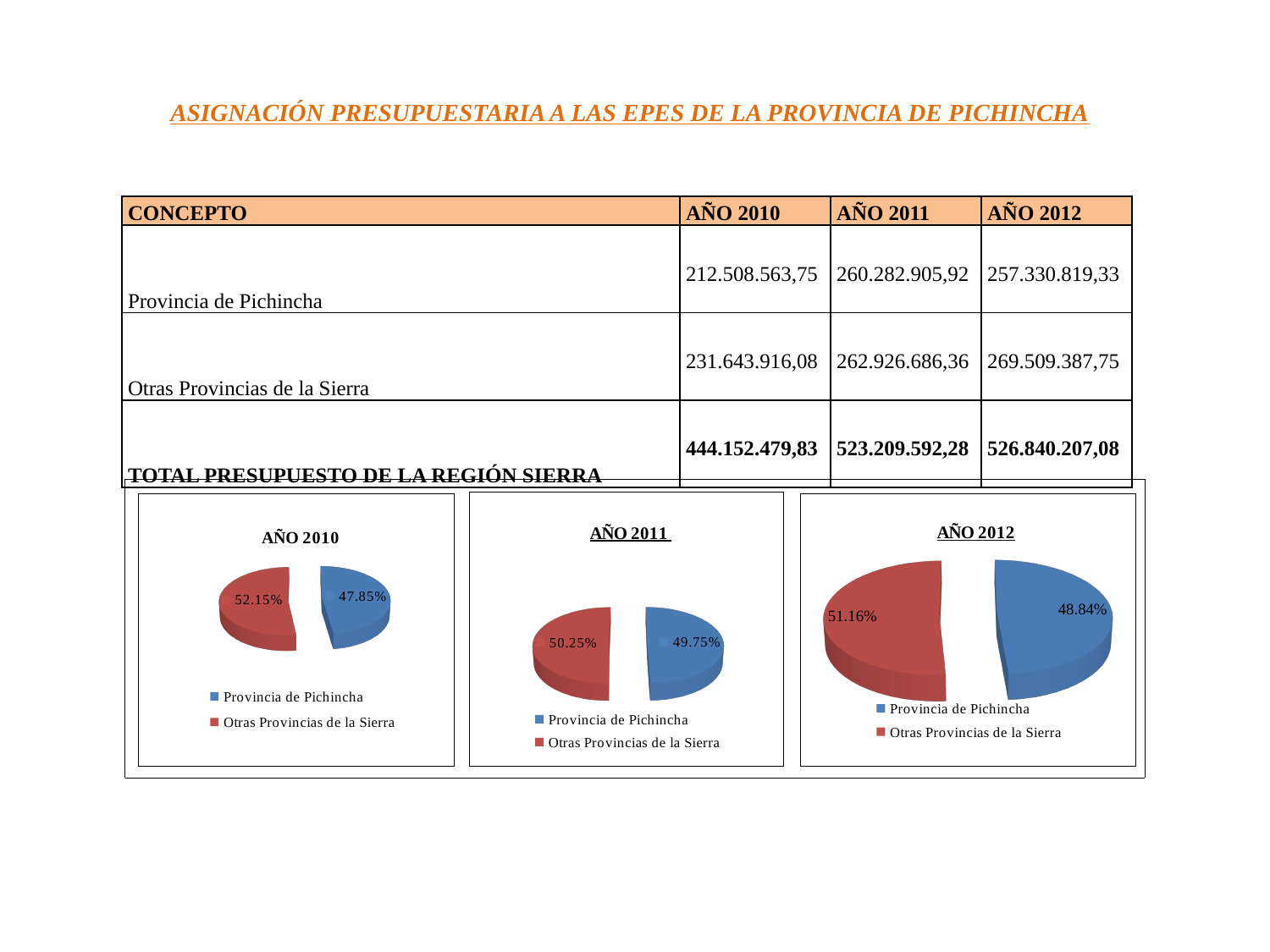
In the AÑO 2010 chart, what share does Otras Provincias de la Sierra have? 52.15% What type of chart is the AÑO 2011 chart? Pie chart In the AÑO 2012 chart, what share does Provincia de Pichincha have? 48.84% How many entries does the legend of the AÑO 2012 chart list? 2 In the AÑO 2012 chart, what is the difference between the Otras Provincias de la Sierra share and the Provincia de Pichincha share? 2.32% In the AÑO 2011 chart, what share does Provincia de Pichincha have? 49.75% In the AÑO 2010 chart, which slice is larger, Provincia de Pichincha or Otras Provincias de la Sierra? Otras Provincias de la Sierra In the AÑO 2012 chart, which category has the largest slice? Otras Provincias de la Sierra In the AÑO 2010 chart, what is the difference between the Otras Provincias de la Sierra share and the Provincia de Pichincha share? 4.30%